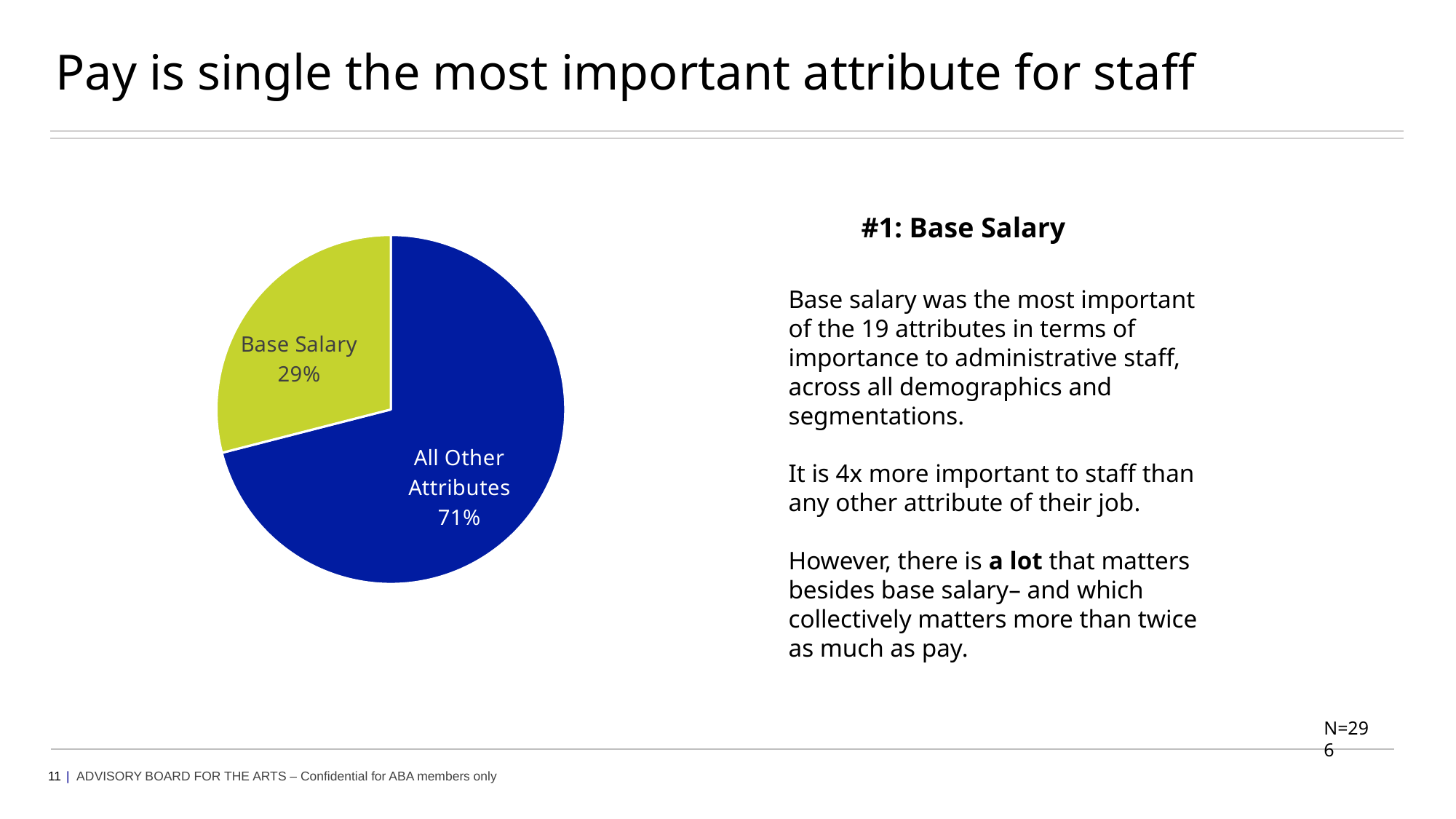
What share of the pie does Base Salary represent? 29% How many slices does the pie chart have? 2 Which slice of the pie is the smallest? Base Salary What share of the pie does All Other Attributes represent? 71% What kind of chart is shown on the slide? Pie chart Which is larger, the Base Salary slice or the All Other Attributes slice? All Other Attributes What colour is the All Other Attributes slice? Blue What colour is the Base Salary slice? Yellow-green What is the difference in percentage points between All Other Attributes and Base Salary? 42 Which slice of the pie is the largest? All Other Attributes